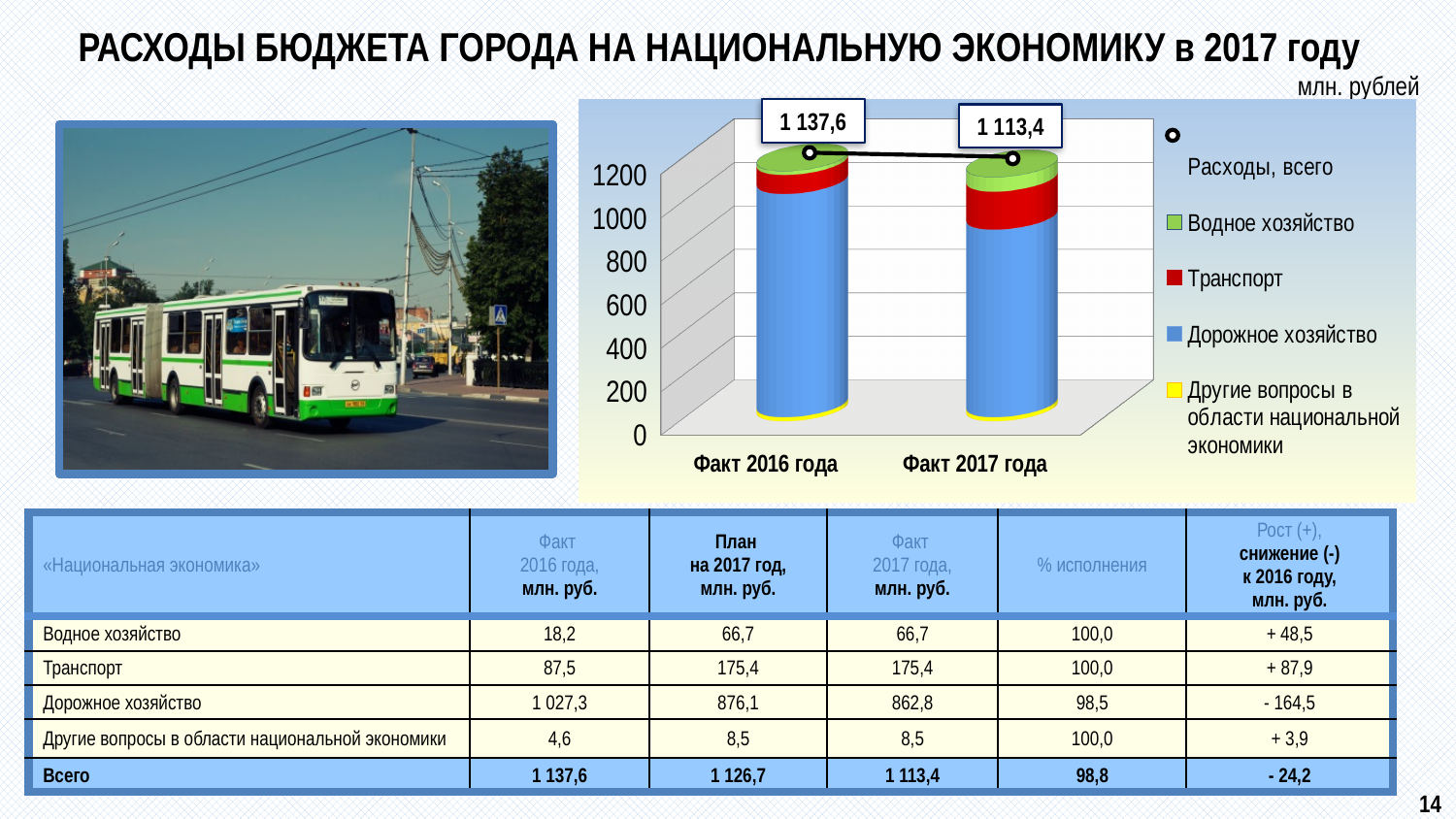
Does the total expenditure rise or fall from Факт 2016 года to Факт 2017 года? Fall Is the Дорожное хозяйство segment larger for Факт 2016 года or for Факт 2017 года? Факт 2016 года How many categories are shown on the x axis of the chart? 2 Which category on the chart has the higher total expenditure, Факт 2016 года or Факт 2017 года? Факт 2016 года Is the Транспорт segment larger for Факт 2016 года or for Факт 2017 года? Факт 2017 года What kind of chart is shown on the slide? Stacked bar chart Which category on the chart has the lower total expenditure? Факт 2017 года How many entries does the chart legend list? 5 What is the value of the data label for Факт 2017 года on the chart? 1 113,4 What is the difference between the total for Факт 2016 года and the total for Факт 2017 года on the chart? 24,2 What is the value of the data label for Факт 2016 года on the chart? 1 137,6 Is the total for Факт 2017 года greater or less than 1000? greater